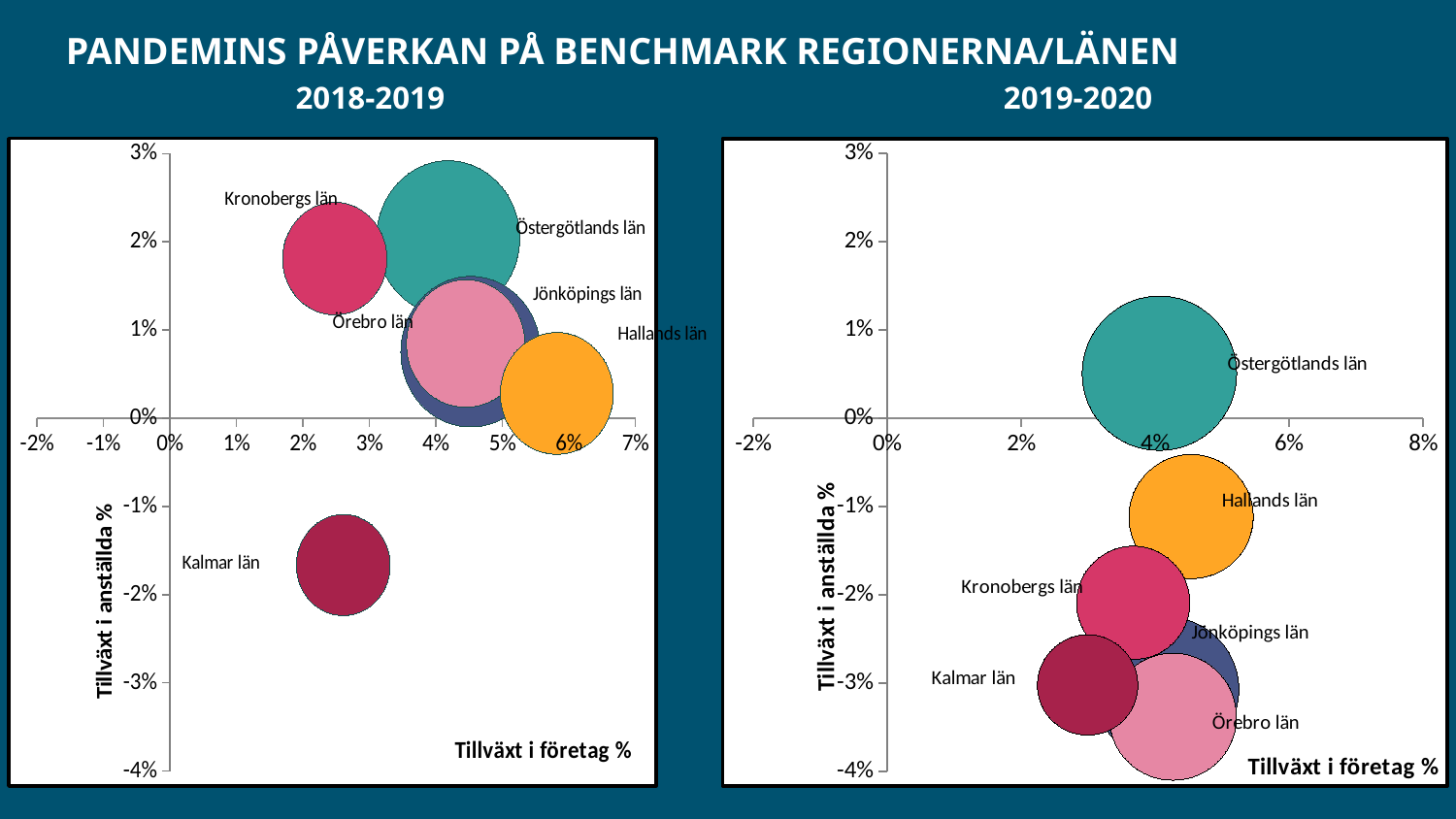
What is the title of the vertical axis in the 2019-2020 chart? Tillväxt i anställda % In the 2018-2019 chart, which region is furthest to the right on the horizontal axis (Tillväxt i företag %)? Hallands län How many regions (bubbles) are plotted in the 2019-2020 chart on the right? 6 In the 2018-2019 chart, is the vertical-axis value for Kalmar län greater or less than 0%? less In the 2018-2019 chart, is the horizontal-axis value for Hallands län greater or less than 5%? greater In the 2019-2020 chart, which region has the higher vertical-axis value, Östergötlands län or Hallands län? Östergötlands län In the 2019-2020 chart, is the vertical-axis value for Kalmar län greater or less than -2%? less What kind of chart is the 2018-2019 chart on the left? Bubble chart In the 2018-2019 chart, which region has the lowest value on the vertical axis (Tillväxt i anställda %)? Kalmar län In the 2019-2020 chart, which region has the lowest value on the vertical axis (Tillväxt i anställda %)? Örebro län In the 2018-2019 chart, which region has the highest value on the vertical axis (Tillväxt i anställda %)? Östergötlands län In the 2019-2020 chart, which region has the highest value on the vertical axis (Tillväxt i anställda %)? Östergötlands län